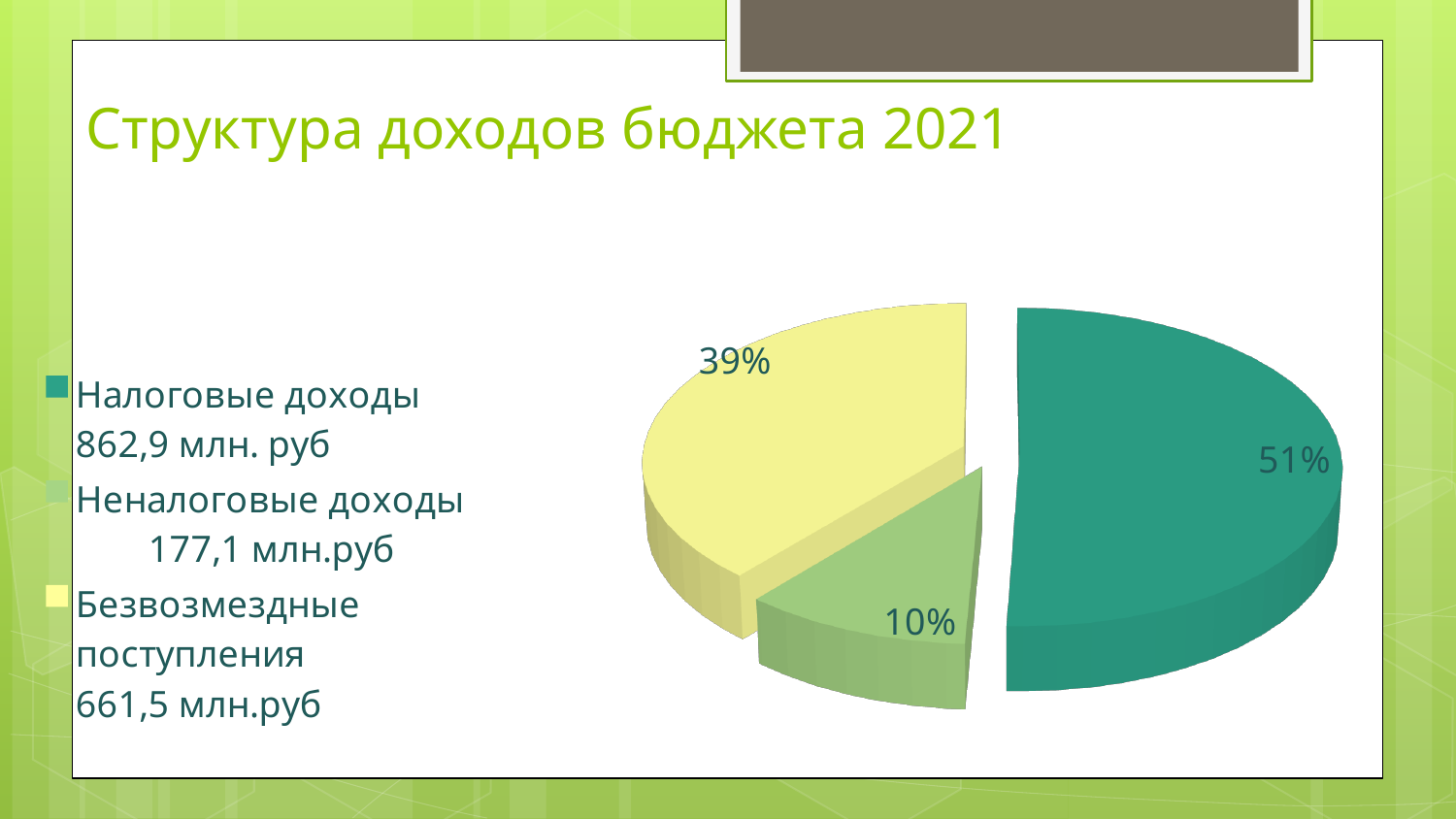
What kind of chart is shown on the slide? pie chart What share of the pie is labelled for Налоговые доходы? 51% What colour is the slice for Безвозмездные поступления? yellow Which category has the smallest slice of the pie? Неналоговые доходы What is the difference in percentage points between the Налоговые доходы slice and the Безвозмездные поступления slice? 12 What share of the pie is labelled for Безвозмездные поступления? 39% Which category has the largest slice of the pie? Налоговые доходы What amount in млн. руб is given for Налоговые доходы in the legend? 862,9 млн. руб What share of the pie is labelled for Неналоговые доходы? 10% Which slice is larger: Безвозмездные поступления or Неналоговые доходы? Безвозмездные поступления What is the title of the slide? Структура доходов бюджета 2021 How many slices does the pie chart have? 3